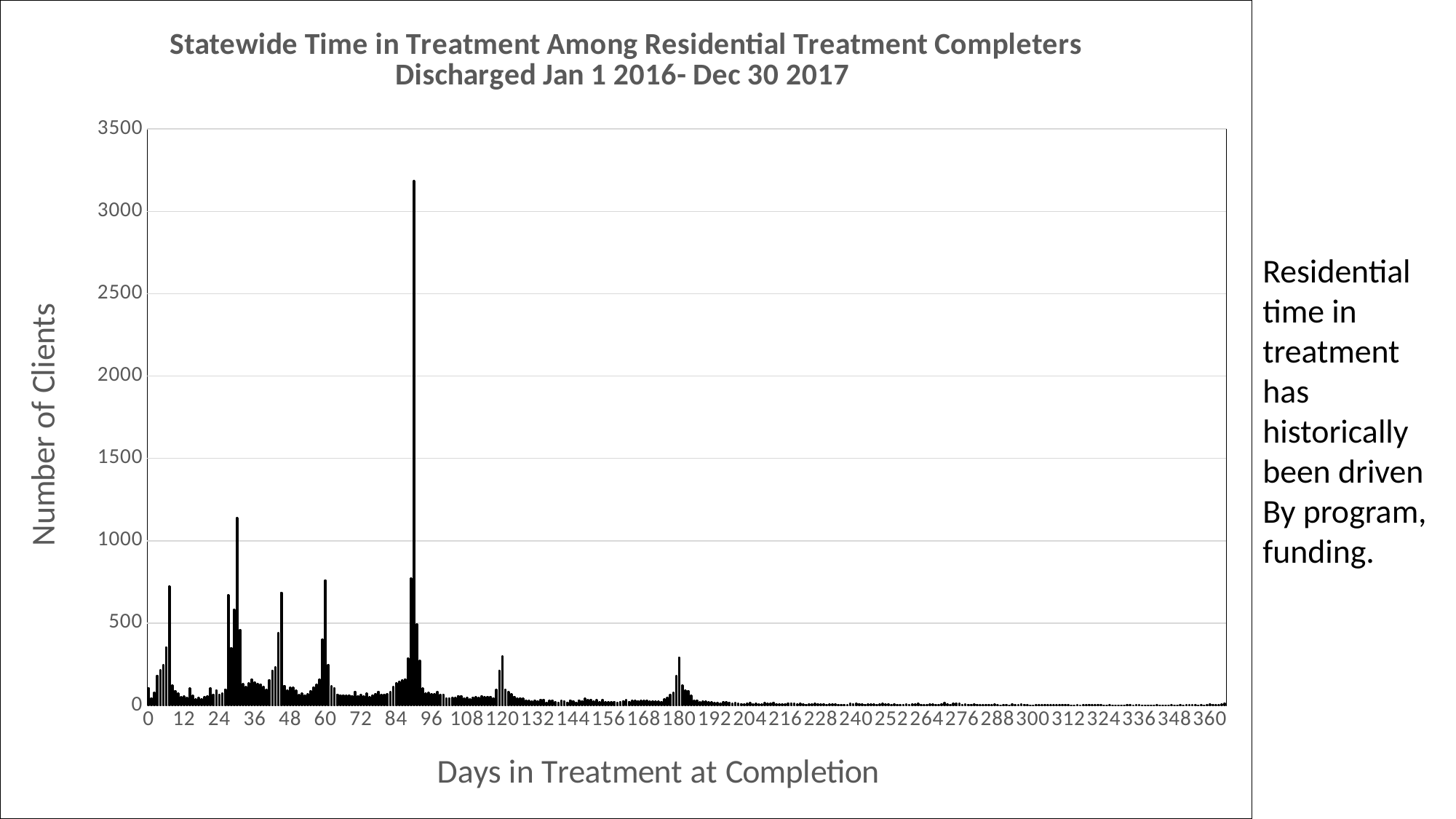
Is the value of the tallest bar near the 180 tick greater or less than 500? less What is the label of the y axis? Number of Clients Is the value of the tallest bar near the 60 tick greater or less than 1000? less Which is taller: the highest bar near the 30-day mark or the highest bar near the 60-day mark? the bar near the 30-day mark What kind of chart is shown on the slide? bar chart Is the value of the tallest bar between the 24 and 36 ticks greater or less than 1000? greater What is the title of the chart? Statewide Time in Treatment Among Residential Treatment Completers Discharged Jan 1 2016- Dec 30 2017 Between which two x-axis tick labels does the tallest bar in the chart fall? 84 and 96 Which is taller: the highest bar near the 90-day mark or the highest bar near the 120-day mark? the bar near the 90-day mark Do the bar heights generally rise or fall as days in treatment increase beyond 200? fall